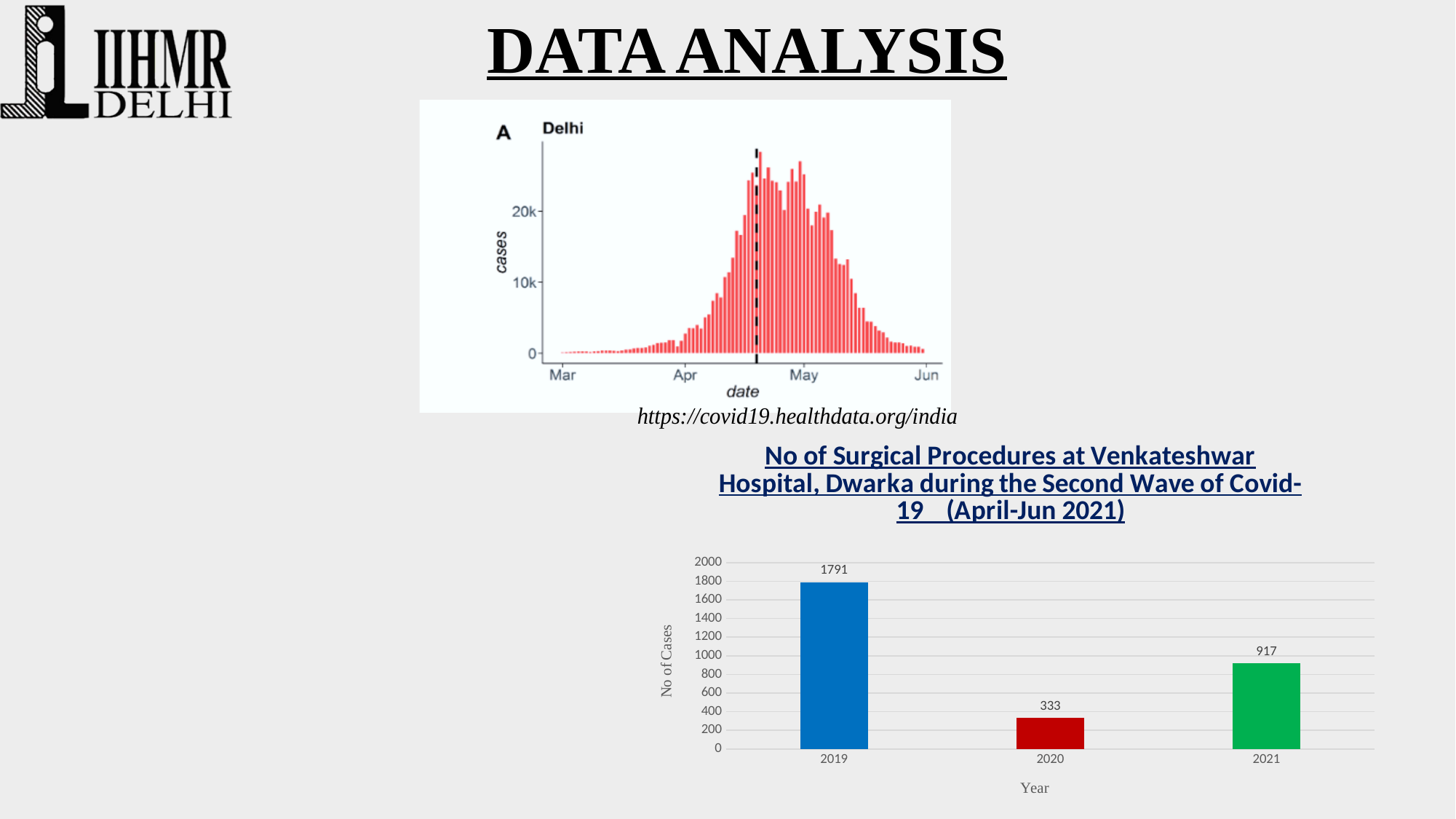
In the bar chart of surgical procedures at Venkateshwar Hospital, what is the value for 2019? 1791 In the bar chart of surgical procedures at Venkateshwar Hospital, what is the difference between the 2021 and 2020 values? 584 In the bar chart of surgical procedures at Venkateshwar Hospital, what is the difference between the 2019 and 2021 values? 874 In the upper Delhi chart, is the peak number of cases greater or less than 20k? greater In the bar chart of surgical procedures at Venkateshwar Hospital, what is the value for 2021? 917 In the bar chart of surgical procedures at Venkateshwar Hospital, what is the value for 2020? 333 In the bar chart of surgical procedures at Venkateshwar Hospital, which year has the lowest number of cases? 2020 What kind of chart is the lower chart on the slide showing surgical procedures by year? bar chart What is the label on the y-axis of the bar chart of surgical procedures at Venkateshwar Hospital? No of Cases In the bar chart of surgical procedures at Venkateshwar Hospital, which year has the highest number of cases? 2019 How many years are shown in the bar chart of surgical procedures at Venkateshwar Hospital? 3 In the bar chart of surgical procedures at Venkateshwar Hospital, which is larger, the value for 2020 or the value for 2021? 2021